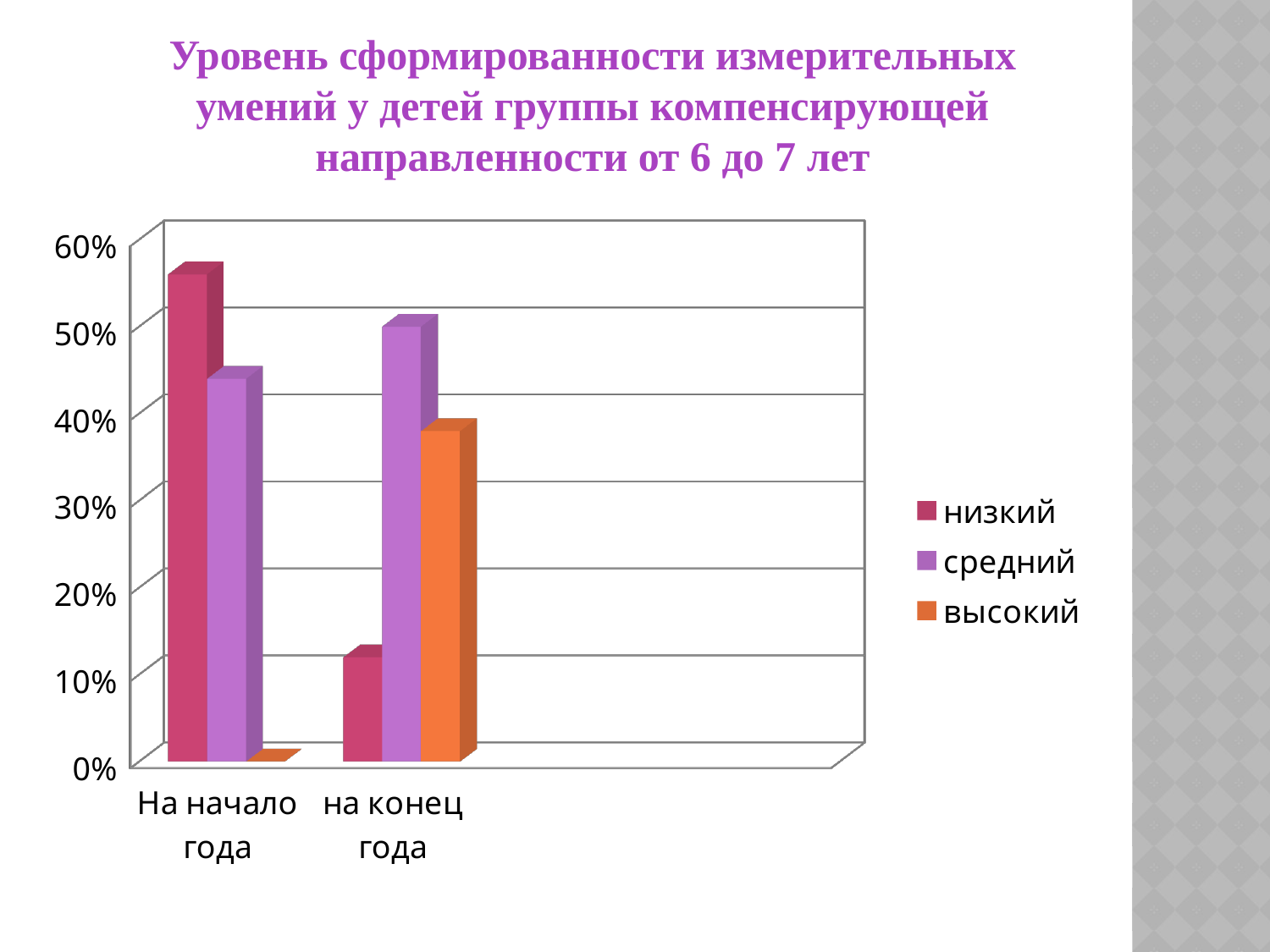
Which series has the lowest value for "на конец года"? низкий Is the value for "высокий" at "на конец года" greater or less than 30%? greater Is the value for "низкий" at "На начало года" greater or less than 50%? greater How many categories are shown on the x axis? 2 Which series has the highest value for "На начало года"? низкий Which is larger: the value for "низкий" at "На начало года" or at "на конец года"? На начало года Which series has the highest value for "на конец года"? средний Is the value for "низкий" at "на конец года" greater or less than 20%? less How many series does the legend list? 3 Does the value for "высокий" rise or fall from "На начало года" to "на конец года"? rise Which series has the lowest value for "На начало года"? высокий What kind of chart is shown on the slide? bar chart